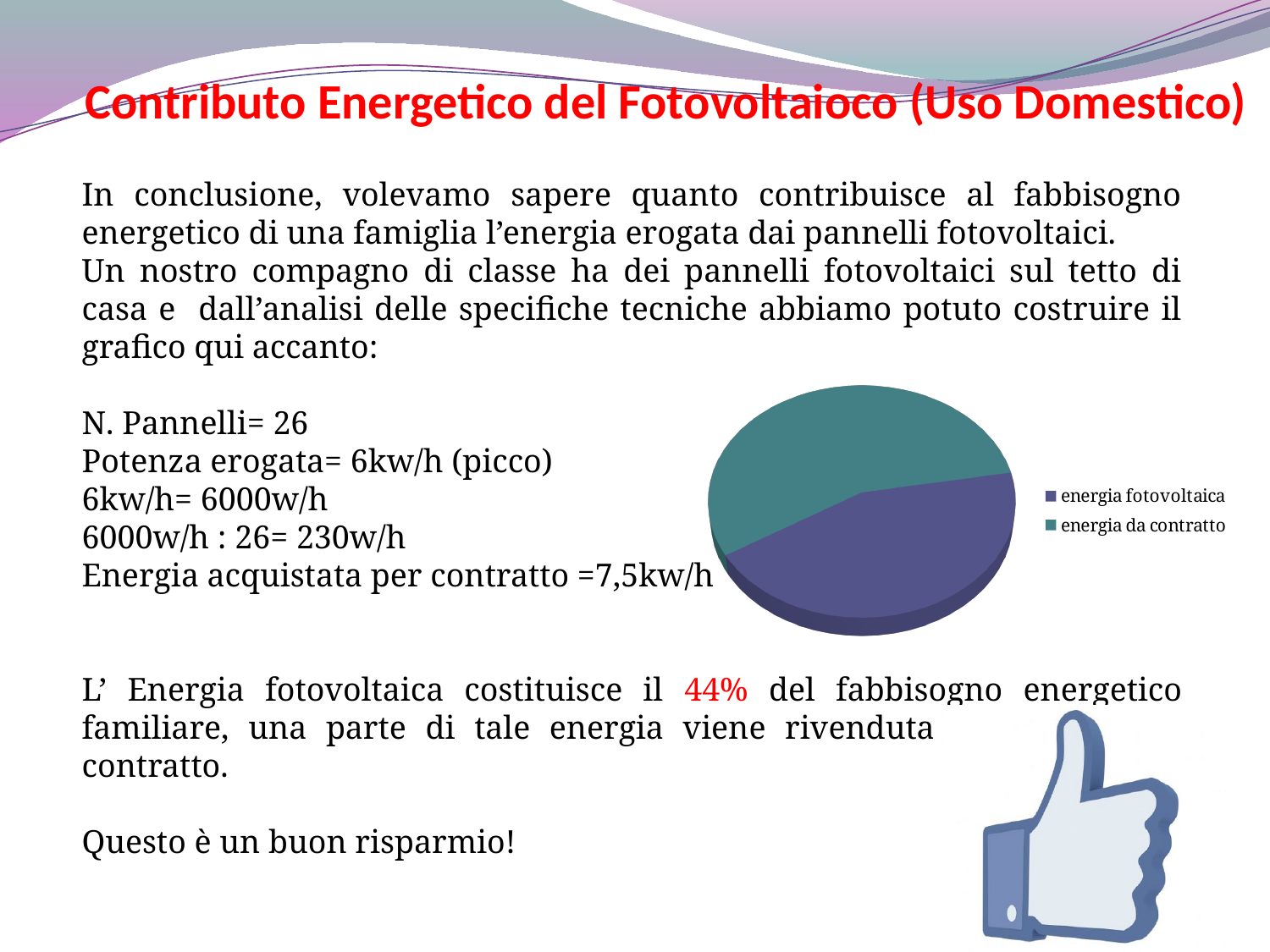
What kind of chart is shown on the slide? pie chart Which slice of the pie chart is the smallest? energia fotovoltaica What colour is the energia fotovoltaica slice in the pie chart? purple How many entries does the legend of the pie chart list? 2 Which slice is larger in the pie chart, energia fotovoltaica or energia da contratto? energia da contratto Which slice of the pie chart is the largest? energia da contratto How many slices does the pie chart have? 2 What are the two legend entries of the pie chart? energia fotovoltaica, energia da contratto